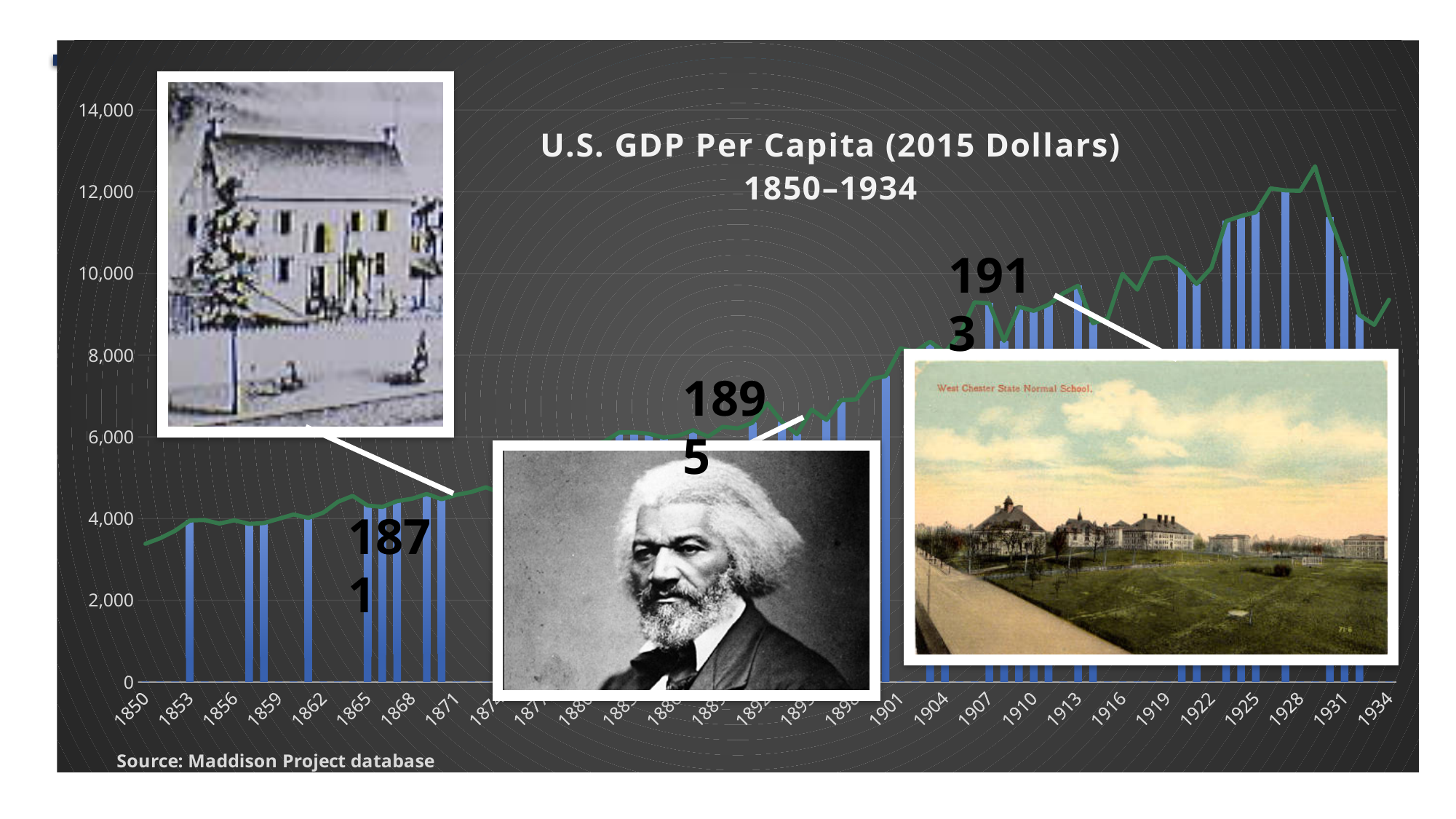
Overall, does U.S. GDP per capita rise or fall from 1850 to 1934? Rise Which year has the larger value, 1853 or 1901? 1901 Is the value for 1850 greater or less than 4,000? less Which year has the larger value, 1928 or 1931? 1928 What kind of chart is shown on the slide? A bar chart with a line overlay What source is cited for the chart's data? Maddison Project database Is the value for 1934 greater or less than 8,000? greater Is the value for 1853 greater or less than 6,000? less What is the highest value shown on the vertical axis? 14,000 What is the title of the chart? U.S. GDP Per Capita (2015 Dollars) 1850–1934